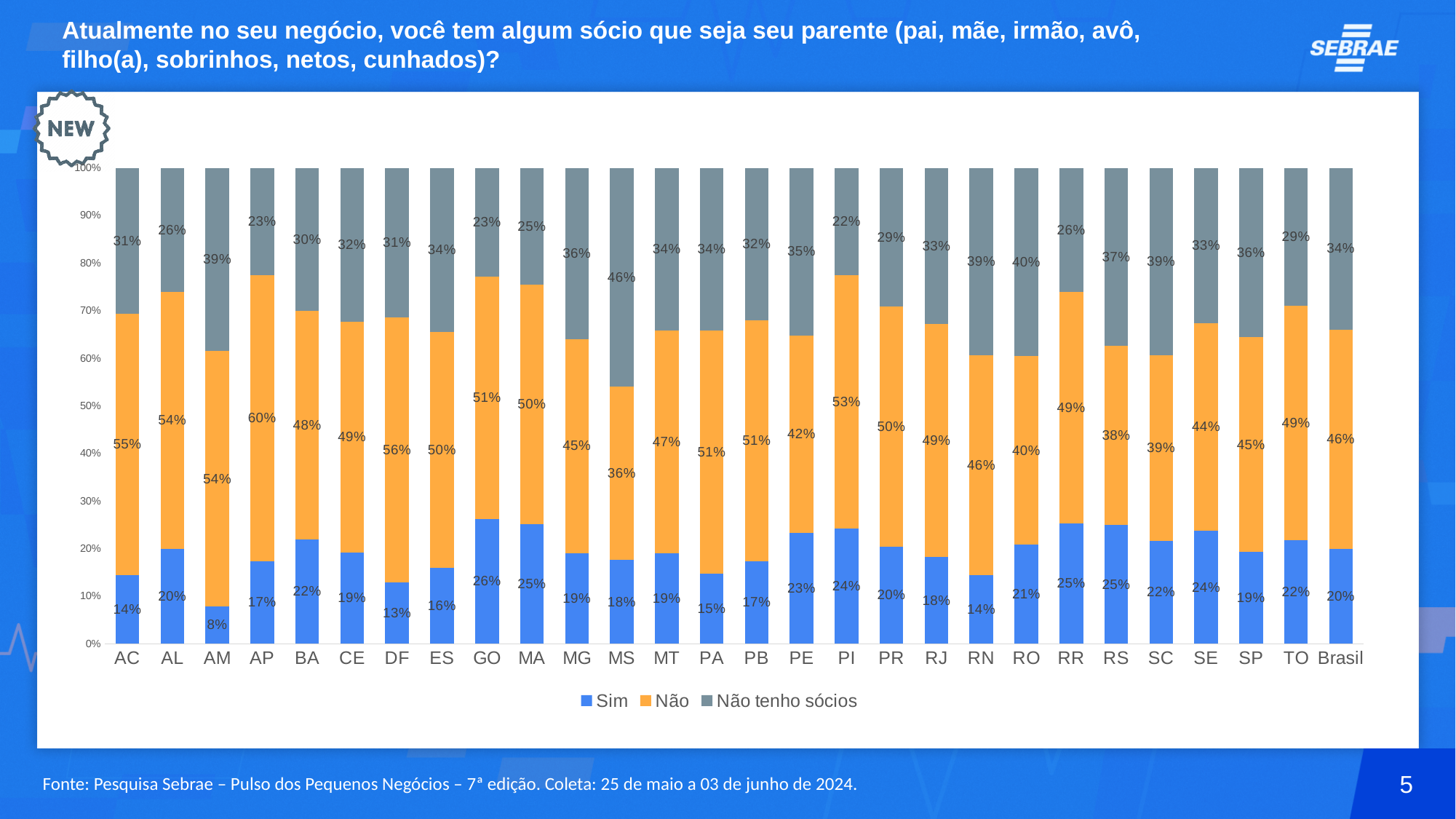
What is the difference between the "Sim" values for GO and AM? 18% What is the value of the "Não tenho sócios" series for MS? 46% Which category has the highest value for the "Sim" series? GO Which category has the lowest value for the "Sim" series? AM How many series does the legend list? 3 How many categories are shown on the x axis? 28 What is the value of the "Não" series for AP? 60% Which is larger: the "Não tenho sócios" value for AM or for AL? AM What kind of chart is shown on the slide? Stacked bar chart Which series is shown in orange in the legend? Não What is the value of the "Sim" series for Brasil? 20% Which category has the lowest value for the "Não" series? MS